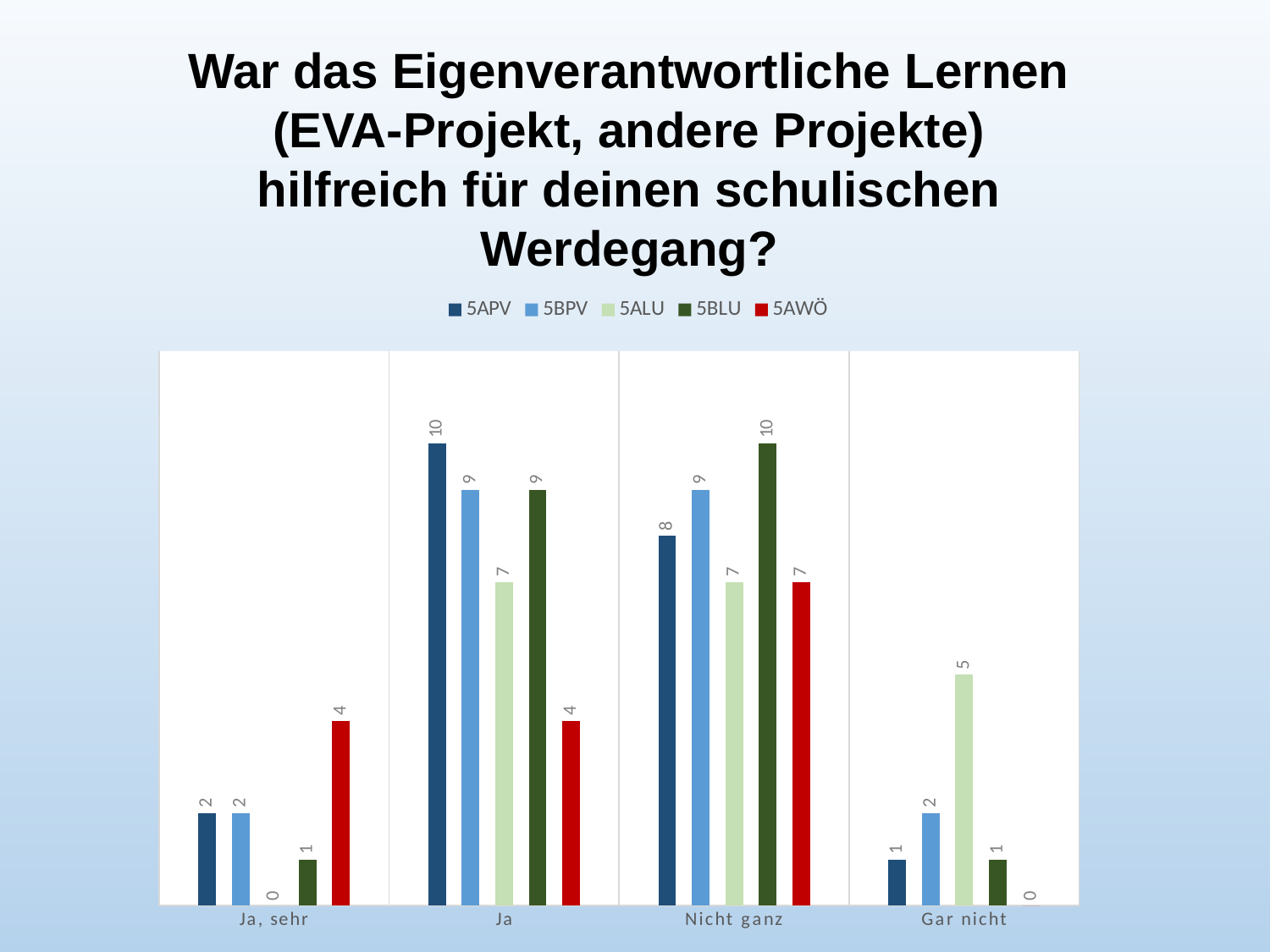
What kind of chart is shown on the slide? Bar chart What is the value for 5ALU in the "Gar nicht" category? 5 What is the value for 5BLU in the "Nicht ganz" category? 10 Which series has the lowest value in the "Ja, sehr" category? 5ALU What is the difference between the 5APV value and the 5AWÖ value in the "Ja" category? 6 What is the value for 5AWÖ in the "Ja, sehr" category? 4 What is the value for 5APV in the "Ja" category? 10 Which series has the highest value in the "Nicht ganz" category? 5BLU How many categories are shown on the x axis? 4 In the "Gar nicht" category, which is larger: the value for 5ALU or the value for 5BPV? 5ALU How many series does the legend list? 5 Which series is shown in red in the legend? 5AWÖ